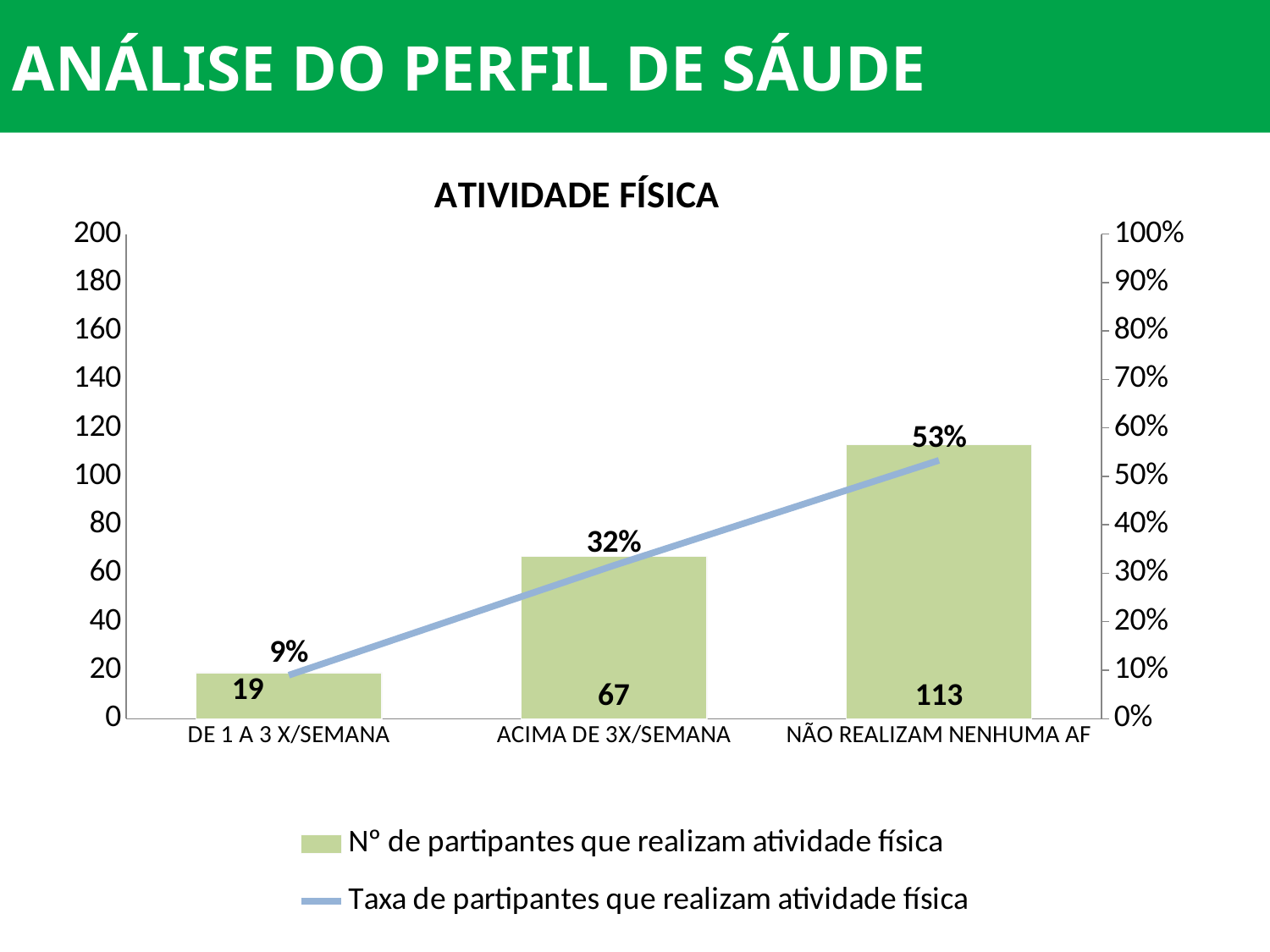
What is the difference in number of participants between NÃO REALIZAM NENHUMA AF and ACIMA DE 3X/SEMANA? 46 What is the number of participants for NÃO REALIZAM NENHUMA AF? 113 Which category has the lowest number of participants? DE 1 A 3 X/SEMANA What is the title of the chart? ATIVIDADE FÍSICA What is the rate (Taxa) shown for ACIMA DE 3X/SEMANA? 32% What is the number of participants for ACIMA DE 3X/SEMANA? 67 What is the number of participants for DE 1 A 3 X/SEMANA? 19 How many series does the legend list? 2 What is the rate (Taxa) shown for NÃO REALIZAM NENHUMA AF? 53% How many categories are shown on the x axis? 3 Which has more participants, DE 1 A 3 X/SEMANA or ACIMA DE 3X/SEMANA? ACIMA DE 3X/SEMANA Which category has the highest number of participants? NÃO REALIZAM NENHUMA AF